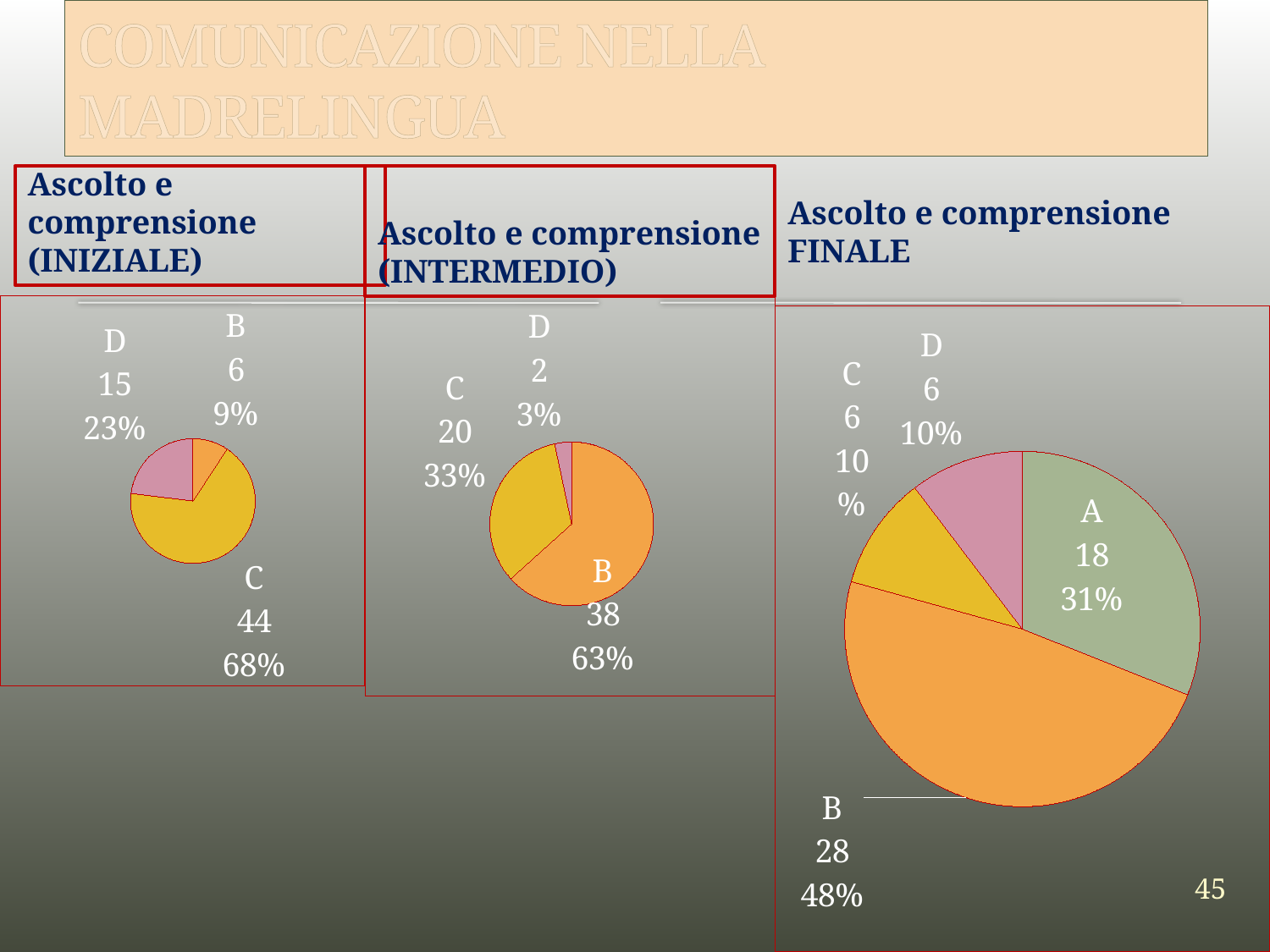
In the 'Ascolto e comprensione (INTERMEDIO)' chart, what is the difference between the values for B and C? 18 In the 'Ascolto e comprensione (INTERMEDIO)' chart, what percentage share does category C have? 33% In the 'Ascolto e comprensione FINALE' chart, what percentage share does category B have? 48% In the 'Ascolto e comprensione (INIZIALE)' chart, what percentage share does category D have? 23% Which is larger: the value for D in the INIZIALE chart or the value for D in the INTERMEDIO chart? INIZIALE (15) How many slices does the 'Ascolto e comprensione FINALE' pie chart have? 4 In the 'Ascolto e comprensione (INIZIALE)' chart, which category has the smallest value? B In the 'Ascolto e comprensione FINALE' chart, what value is shown for category A? 18 What type of chart is used for 'Ascolto e comprensione (INTERMEDIO)'? Pie chart In the 'Ascolto e comprensione FINALE' chart, which category has the largest share? B In the 'Ascolto e comprensione (INTERMEDIO)' chart, what value is shown for category B? 38 In the 'Ascolto e comprensione (INIZIALE)' chart, what value is shown for category C? 44